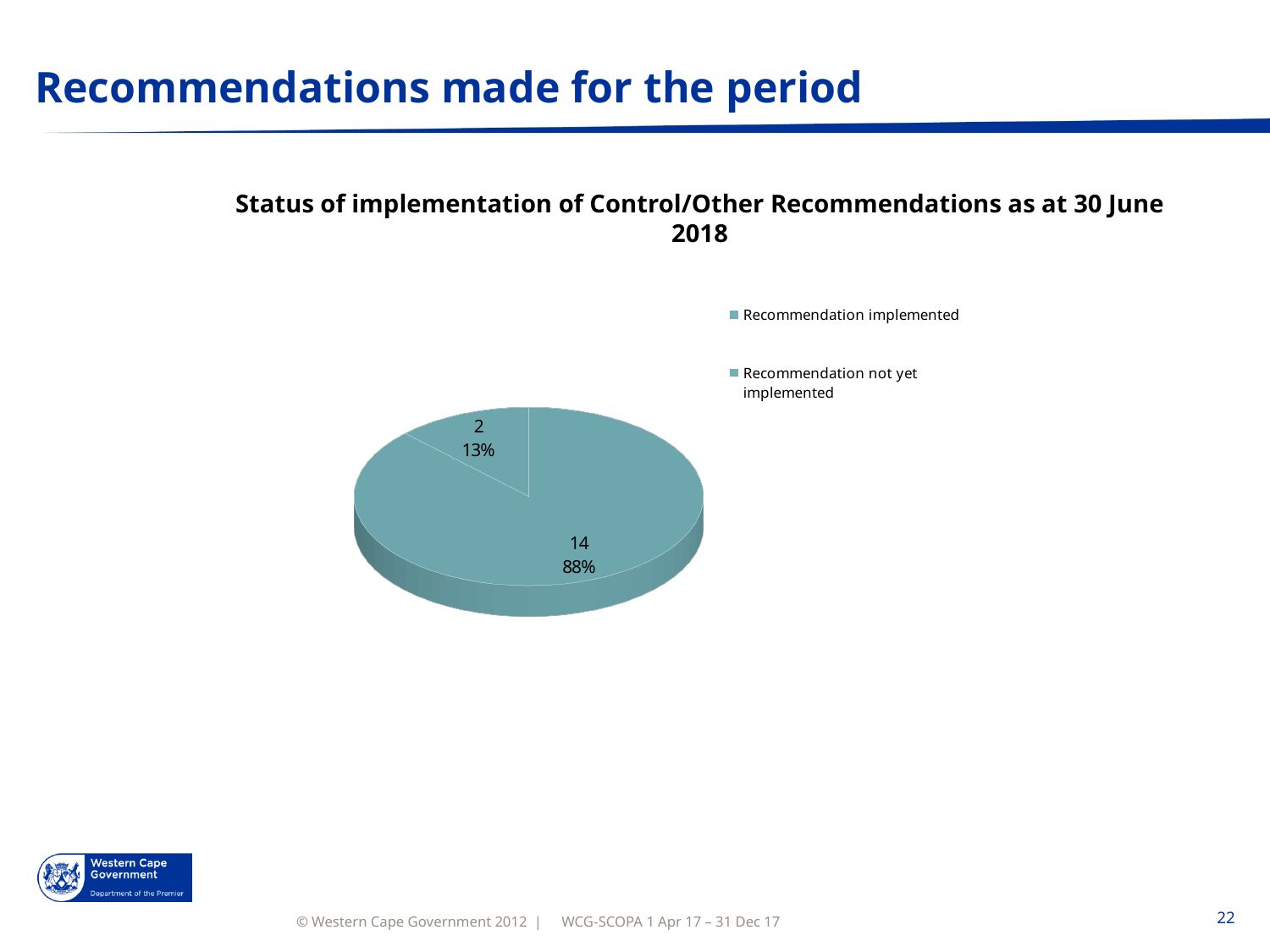
What percentage share is shown on the smallest slice? 13% How many slices does the pie chart have? 2 What is the total of the counts shown on the two slices? 16 What count is shown on the largest slice of the pie chart? 14 What is the second entry listed in the legend? Recommendation not yet implemented What kind of chart is shown on the slide? pie chart How many entries does the legend list? 2 What is the title of the chart? Status of implementation of Control/Other Recommendations as at 30 June 2018 What percentage share is shown on the largest slice? 88% What count is shown on the smallest slice of the pie chart? 2 What is the difference between the counts shown on the two slices? 12 Which is larger, the slice labelled 14 or the slice labelled 2? the slice labelled 14